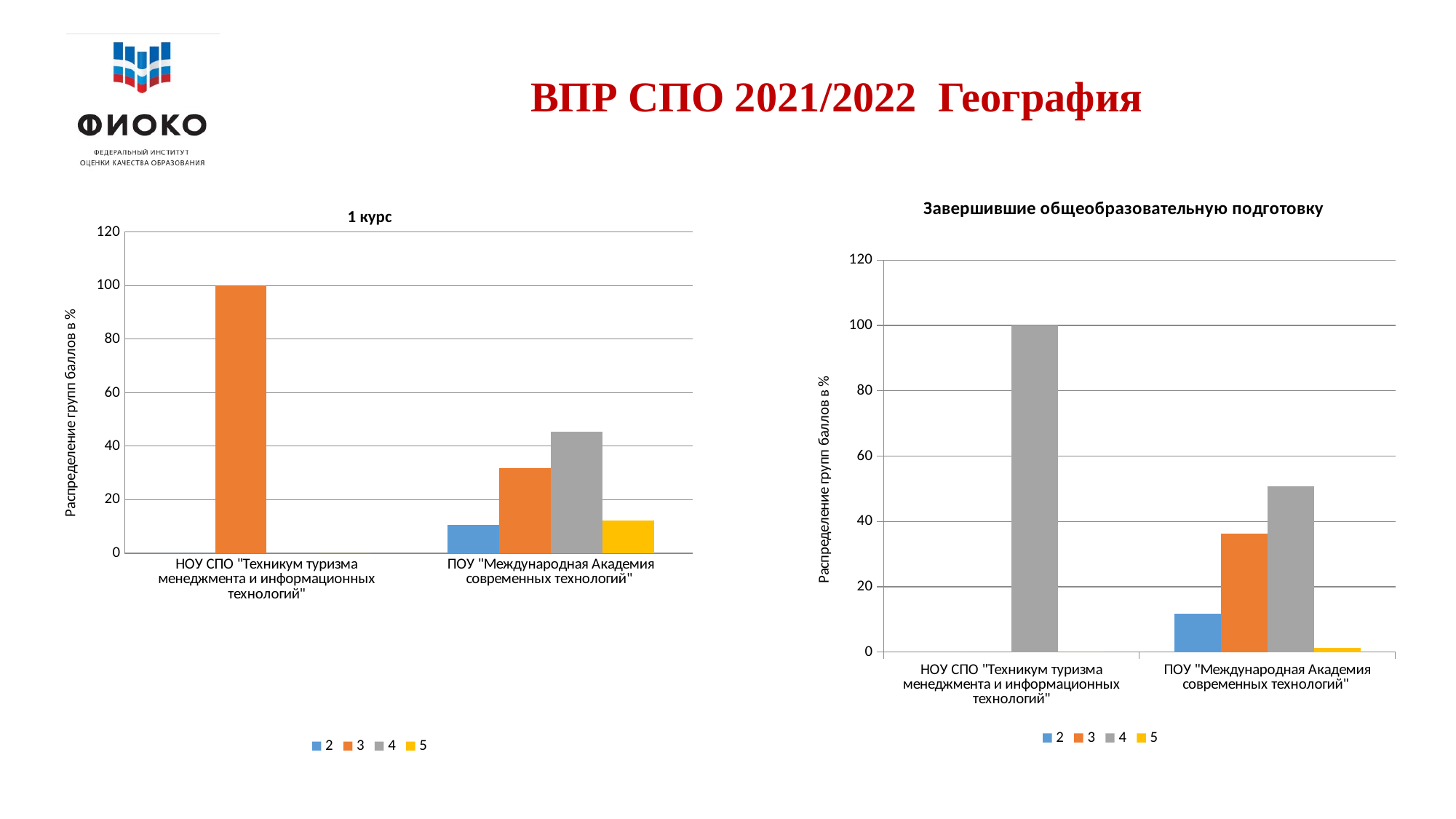
In the chart titled "Завершившие общеобразовательную подготовку", what is the value for series 4 for НОУ СПО "Техникум туризма менеджмента и информационных технологий"? 100 In the chart titled "1 курс", is the value for series 4 for ПОУ "Международная Академия современных технологий" greater or less than 40? greater In the chart titled "1 курс", which is larger for ПОУ "Международная Академия современных технологий": series 3 or series 2? 3 What kind of chart is the chart titled "Завершившие общеобразовательную подготовку"? bar chart In the chart titled "Завершившие общеобразовательную подготовку", is the value for series 3 for ПОУ "Международная Академия современных технологий" greater or less than 20? greater In the chart titled "Завершившие общеобразовательную подготовку", which series has the lowest value for ПОУ "Международная Академия современных технологий"? 5 In the chart titled "1 курс", is the value for series 3 for ПОУ "Международная Академия современных технологий" greater or less than 40? less In the chart titled "1 курс", which series has the highest value for ПОУ "Международная Академия современных технологий"? 4 How many categories are shown on the x axis of the chart titled "Завершившие общеобразовательную подготовку"? 2 How many series does the legend of the chart titled "1 курс" list? 4 In the chart titled "1 курс", what is the value for series 3 for НОУ СПО "Техникум туризма менеджмента и информационных технологий"? 100